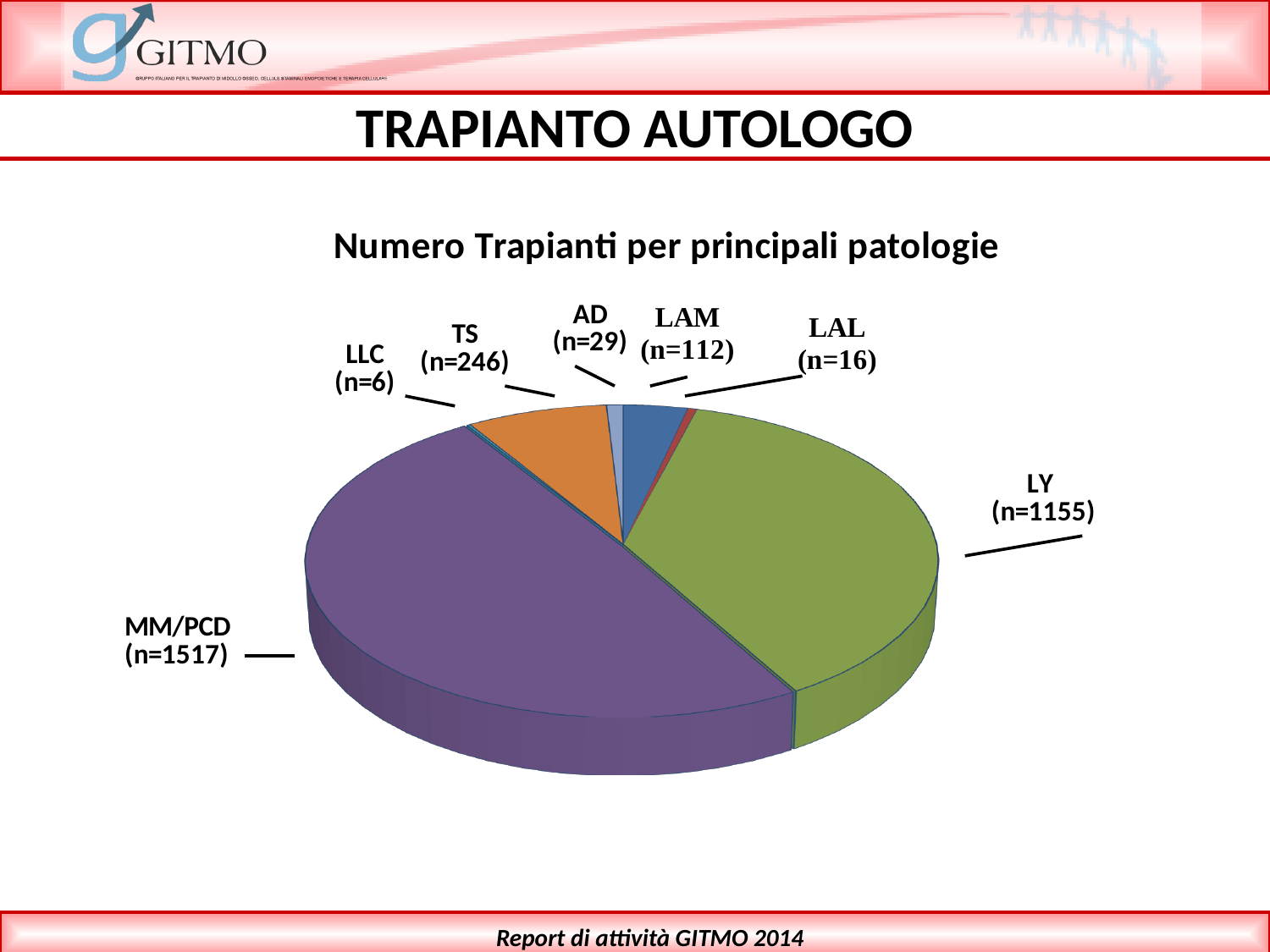
What is the number of transplants (n) for MM/PCD? 1517 Which category has the smallest number of transplants? LLC How many disease categories (slices) does the pie chart show? 7 What is the number of transplants (n) for TS? 246 What is the title of the pie chart? Numero Trapianti per principali patologie What is the number of transplants (n) for LAM? 112 Which has more transplants, LAM or AD? LAM What is the number of transplants (n) for LY? 1155 Which category has the largest number of transplants? MM/PCD What kind of chart is shown on the slide? pie chart What is the difference between the number of transplants for MM/PCD and for LY? 362 What is the total number of transplants across all categories shown in the pie chart? 3081